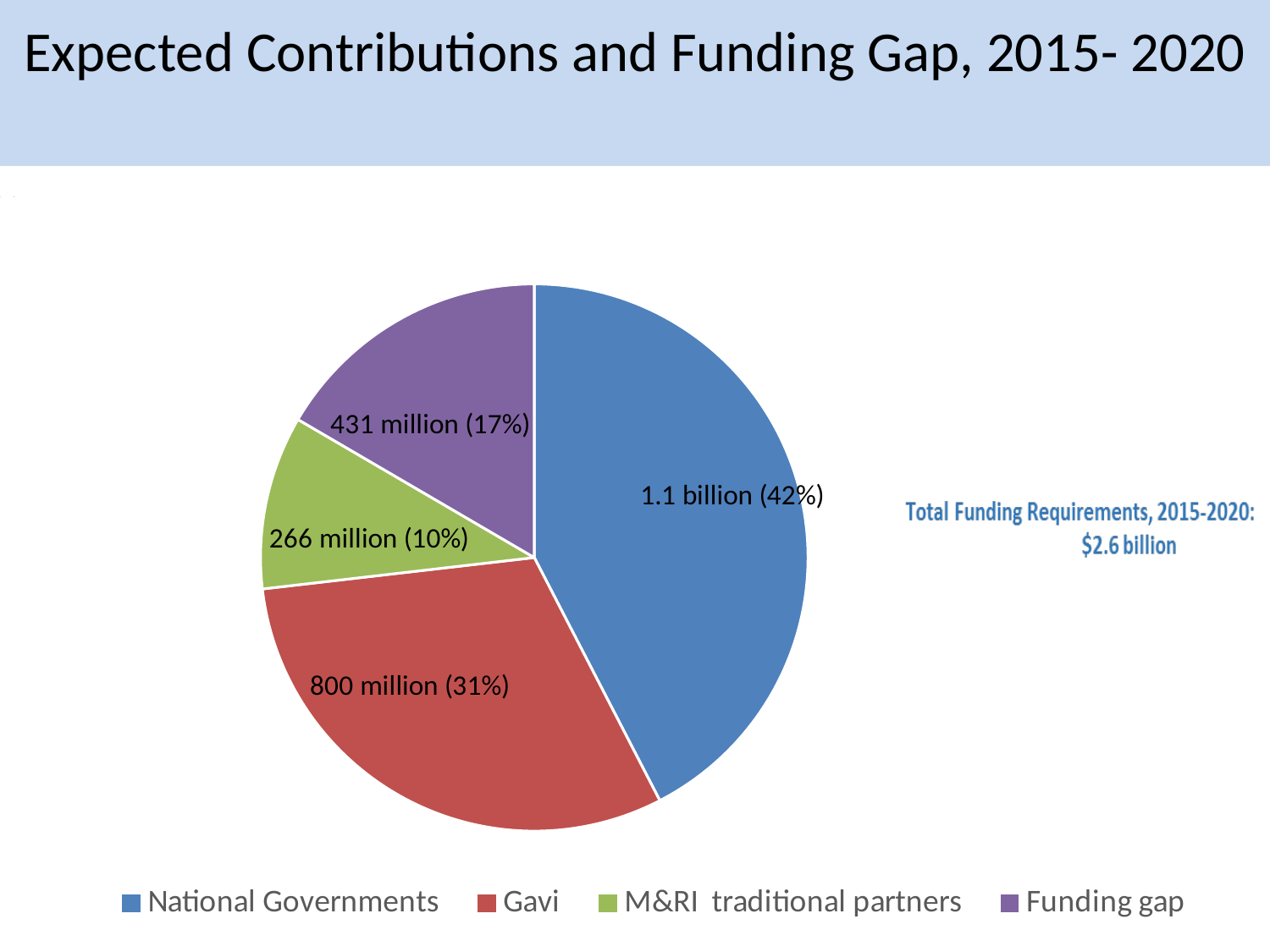
What is the value shown for M&RI traditional partners? 266 million (10%) What is the value shown for National Governments? 1.1 billion (42%) What share of the pie does Gavi represent? 31% Which category has the largest slice of the pie? National Governments What is the value shown for the Funding gap? 431 million (17%) Which category has the smallest slice of the pie? M&RI traditional partners What kind of chart is shown on the slide? Pie chart What is the value shown for Gavi? 800 million (31%) Which is larger, the Funding gap slice or the M&RI traditional partners slice? Funding gap What total funding requirement for 2015-2020 is stated next to the chart? $2.6 billion How many categories does the pie chart have? 4 What is the difference in percentage points between the National Governments share and the Gavi share? 11 percentage points